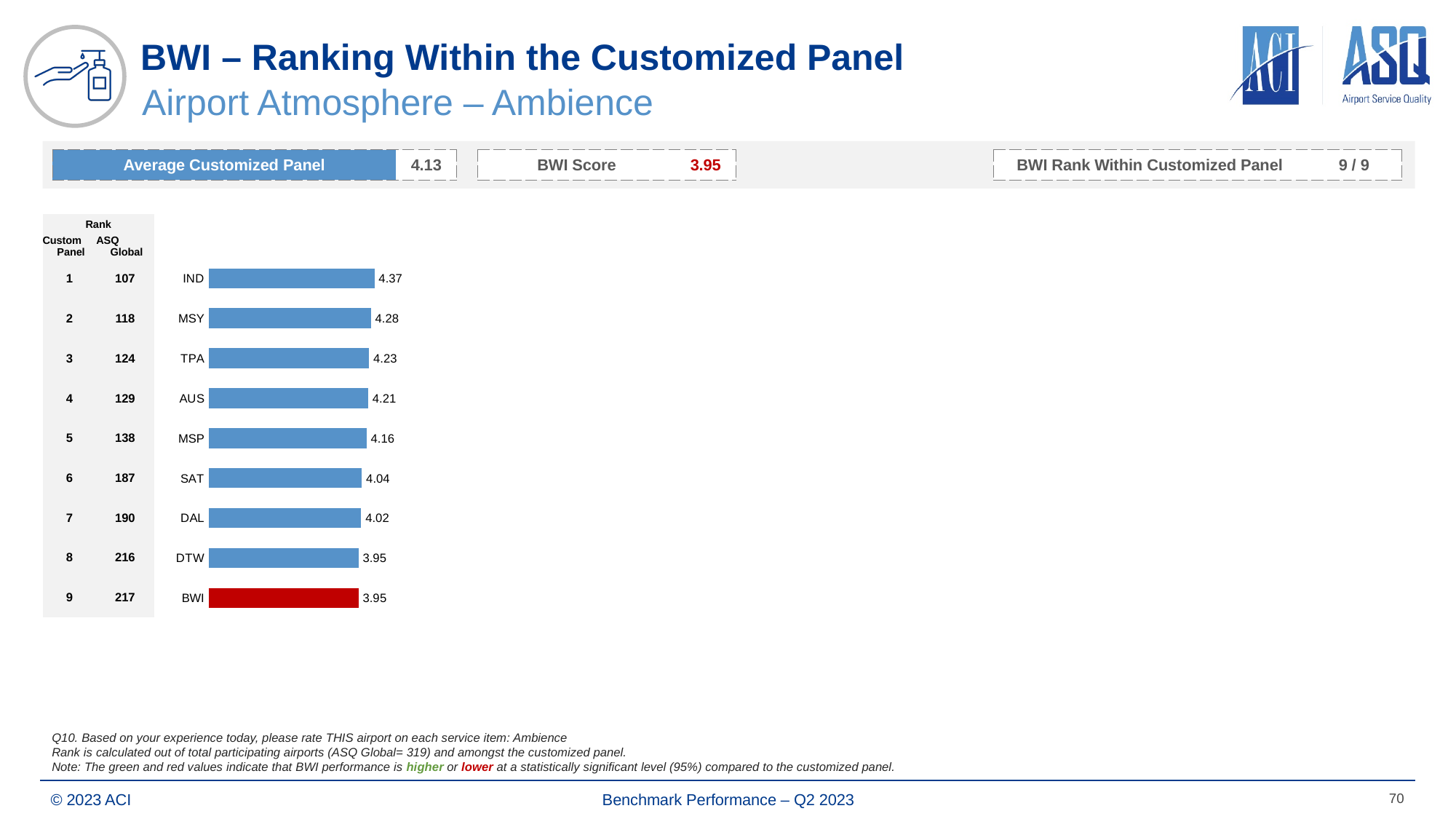
How many airports are shown in the chart? 9 Which bar is coloured red? BWI What kind of chart is shown? bar chart Which is larger, the value for TPA or the value for DAL? TPA Which airport has the highest value? IND What is the difference between the values for MSY and SAT? 0.24 What is the value for MSP? 4.16 What is the difference between the values for IND and BWI? 0.42 Do the values rise or fall going down the chart from IND to BWI? fall What is the value for BWI? 3.95 What is the value for IND? 4.37 What is the Average Customized Panel value shown on the slide? 4.13